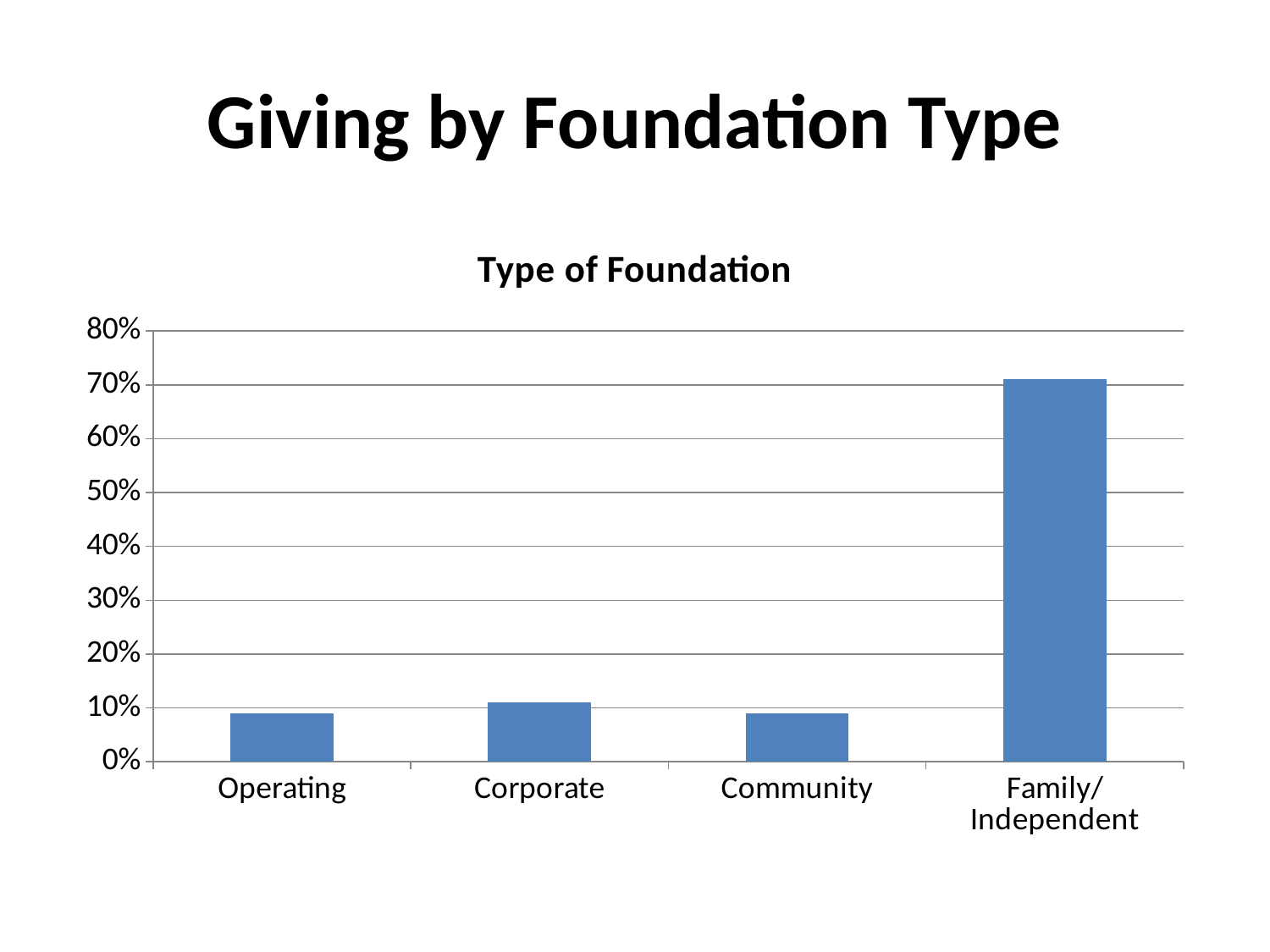
Which is larger, the value for Corporate or the value for Community? Corporate Is the value for Community greater or less than 20%? less Which foundation type has the highest value in the chart? Family/Independent What is the highest value shown on the y axis of the chart? 80% Is the value for Family/Independent greater or less than 80%? less How many foundation types are shown on the x axis of the chart? 4 What kind of chart is shown on the slide? bar chart What is the title of the chart? Type of Foundation Which is larger, the value for Family/Independent or the value for Corporate? Family/Independent